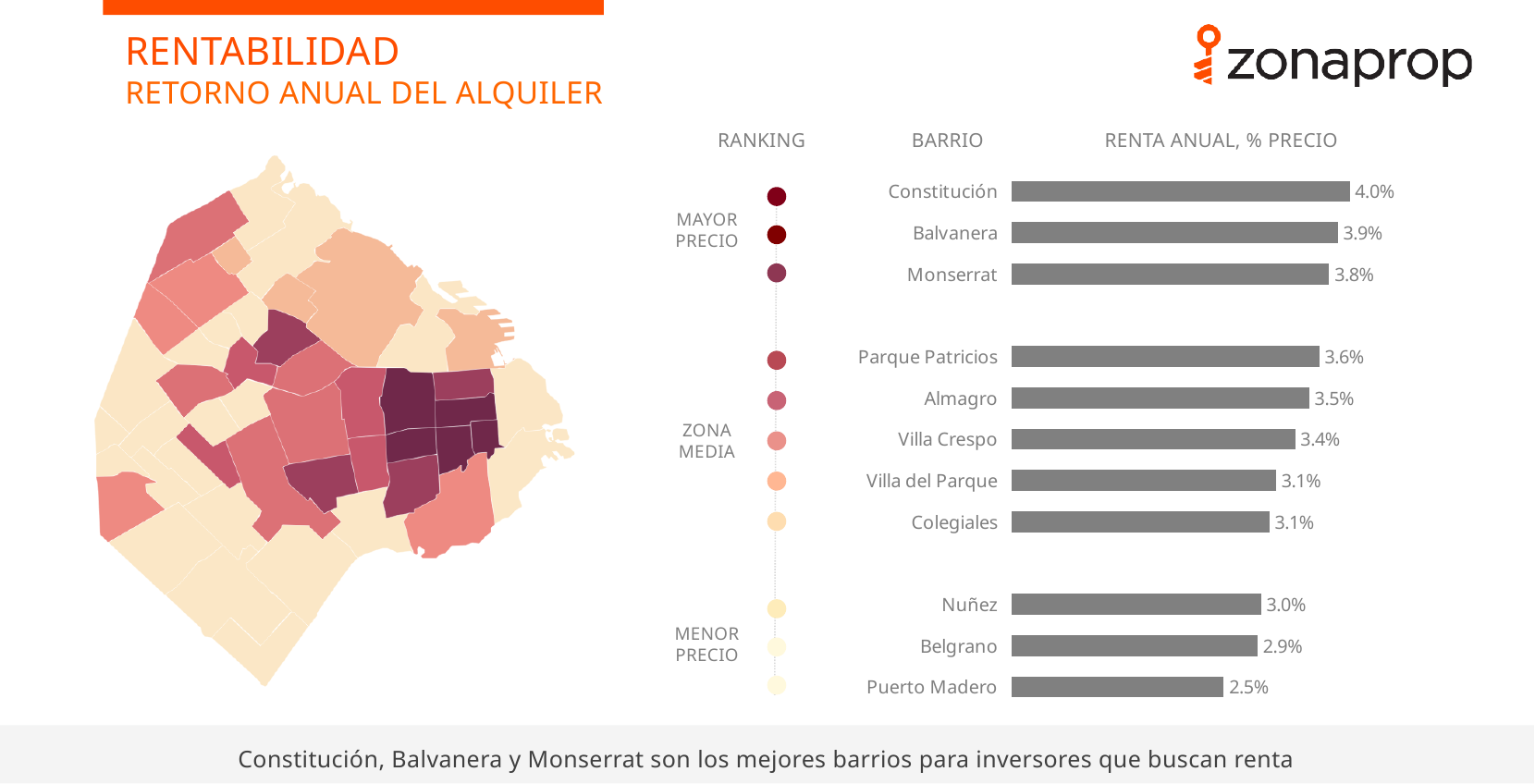
Which two barrios share the same annual rent return of 3.1%? Villa del Parque and Colegiales What is the annual rent return shown for Puerto Madero? 2.5% What kind of chart is used to show the annual rent return? Bar chart Which has a higher annual rent return, Almagro or Villa Crespo? Almagro Do the annual rent return values rise or fall going from the top bar to the bottom bar? Fall What value is shown for Villa Crespo? 3.4% What is the annual rent return (renta anual, % precio) for Constitución? 4.0% How many barrios are listed in the chart? 11 What is the difference in annual rent return between Constitución and Puerto Madero? 1.5 percentage points What is the annual rent return for Nuñez? 3.0% Which barrio has the lowest annual rent return? Puerto Madero Which barrio has the highest annual rent return? Constitución